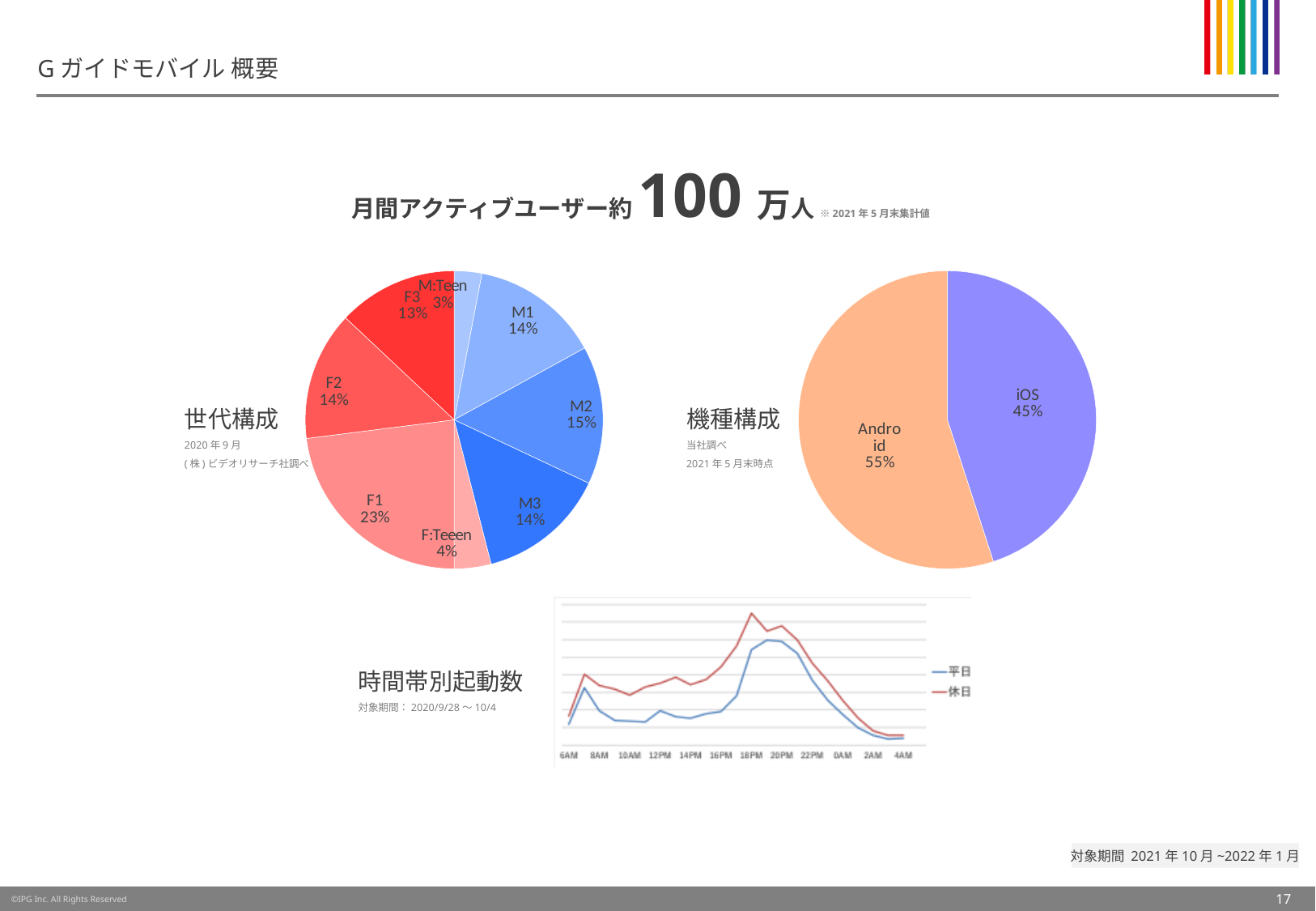
In the 世代構成 pie chart, which category has the smallest share? M:Teen How many series does the legend of the 時間帯別起動数 chart list? 2 In the 機種構成 pie chart, what is the difference in percentage points between Android and iOS? 10 In the 世代構成 pie chart, what is the difference in percentage points between F1 and F3? 10 In the 世代構成 pie chart, which is larger, M2 or F:Teeen? M2 How many slices does the 世代構成 pie chart have? 8 In the 世代構成 pie chart, which category has the largest share? F1 In the 機種構成 pie chart, which platform has the larger share? Android In the 機種構成 pie chart, what share does iOS have? 45% In the 世代構成 pie chart, what share does F1 have? 23% In the 世代構成 pie chart, what share does M2 have? 15% What kind of chart is the 時間帯別起動数 chart? line chart